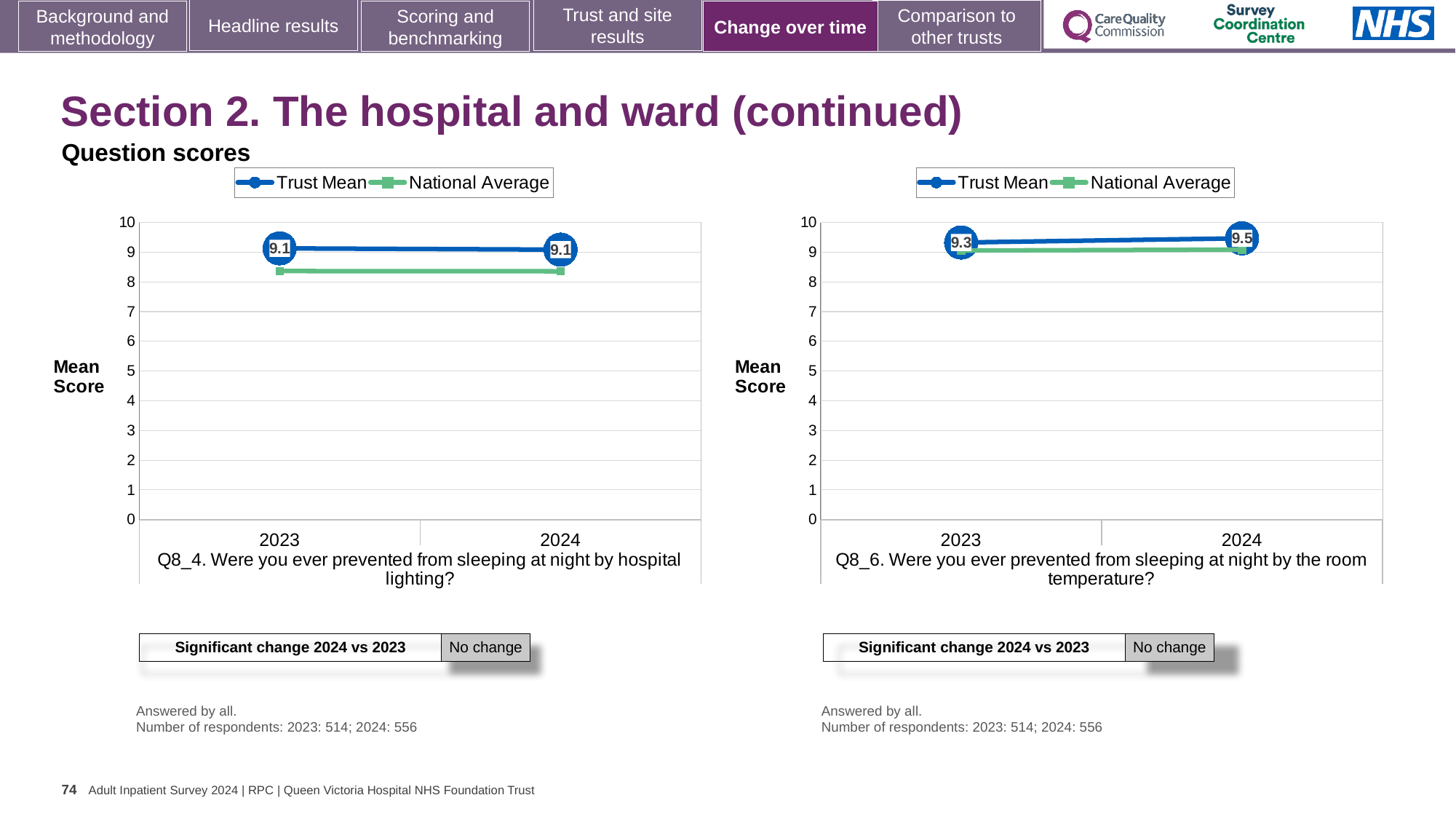
In the Q8_6 chart (right), does the Trust Mean rise or fall from 2023 to 2024? rise In the Q8_4 chart (left), what is the Trust Mean for 2023? 9.1 How many series does the legend of the Q8_4 chart (left) list? 2 How many years are plotted on the x axis of the Q8_6 chart (right)? 2 In the Q8_6 chart (right), what is the Trust Mean for 2023? 9.3 In the Q8_4 chart (left), what is the Trust Mean for 2024? 9.1 In the Q8_4 chart (left), is the National Average for 2023 greater or less than 9? less In the Q8_6 chart (right), is the National Average for 2024 greater or less than 8? greater In the Q8_6 chart (right), what is the difference between the Trust Mean for 2024 and 2023? 0.2 In the Q8_4 chart (left), which is larger in 2024, the Trust Mean or the National Average? Trust Mean In the Q8_6 chart (right), what is the Trust Mean for 2024? 9.5 What kind of chart is the Q8_4 chart (left)? line chart